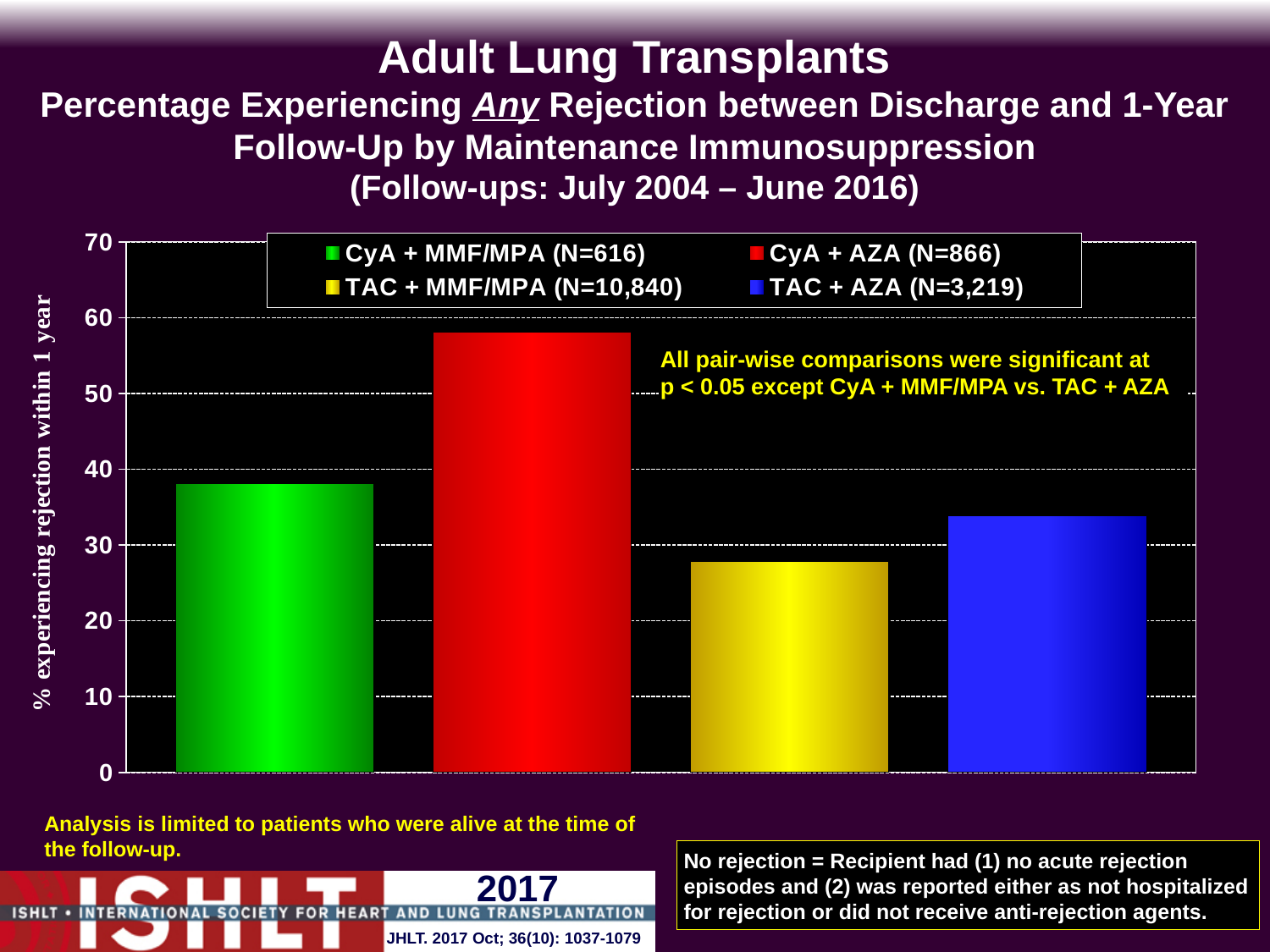
Which maintenance immunosuppression group has the lowest percentage experiencing rejection within 1 year? TAC + MMF/MPA (N=10,840) Which has a higher percentage experiencing rejection, CyA + MMF/MPA or TAC + AZA? CyA + MMF/MPA Is the value for CyA + MMF/MPA greater or less than 40? less What colour is the bar for TAC + MMF/MPA? yellow How many bars are plotted in the chart? 4 Is the value for CyA + AZA greater or less than 50? greater Is the value for TAC + MMF/MPA greater or less than 30? less What is the label on the vertical axis of the chart? % experiencing rejection within 1 year How many series does the legend list? 4 What kind of chart is shown on the slide? bar chart Which maintenance immunosuppression group has the highest percentage experiencing rejection within 1 year? CyA + AZA (N=866)